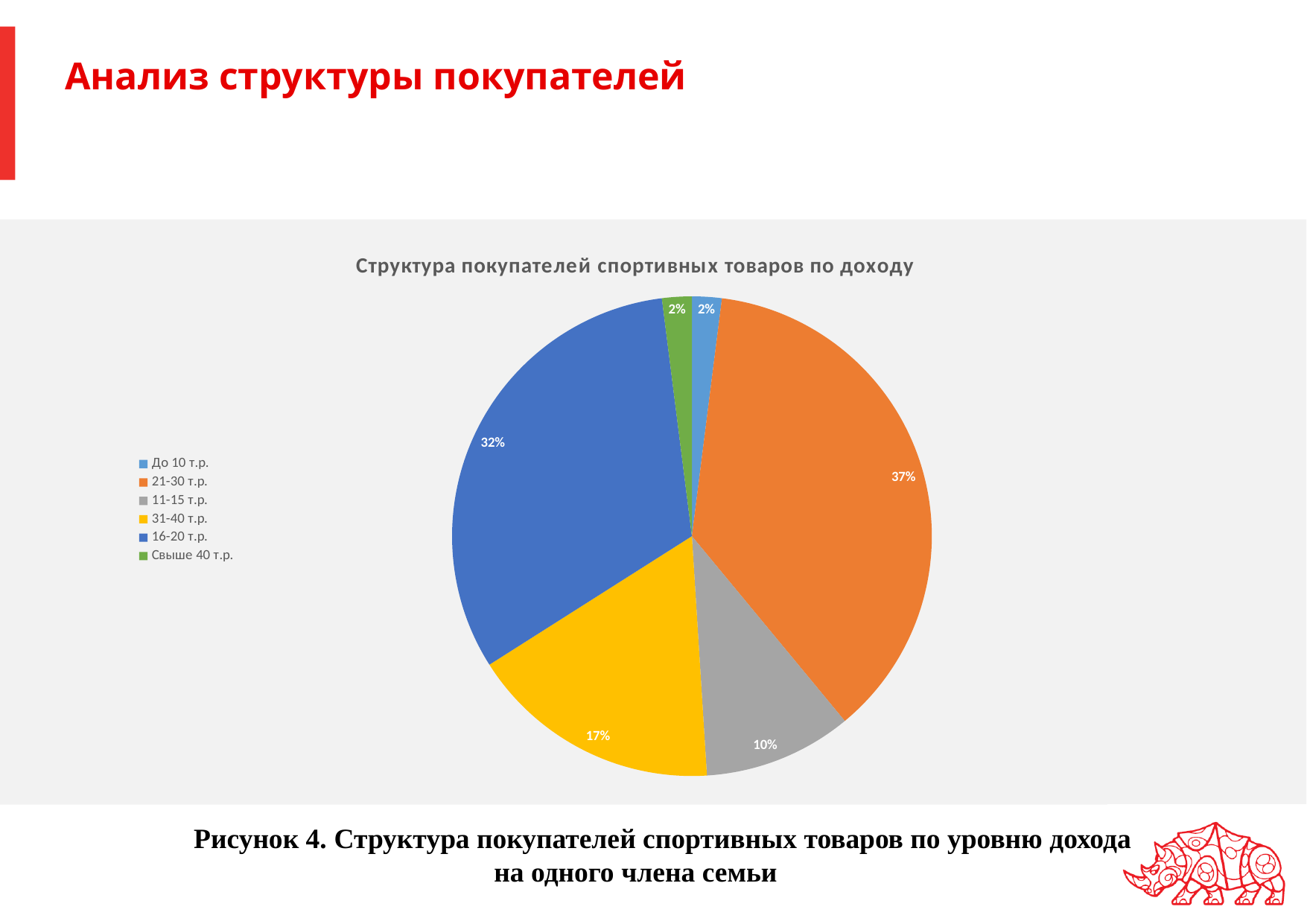
How many income groups does the legend list? 6 What share of buyers falls in the 31-40 т.р. income group? 17% What colour is the slice for the 31-40 т.р. group? yellow What share of buyers falls in the Свыше 40 т.р. income group? 2% Which group has a larger share: 31-40 т.р. or 11-15 т.р.? 31-40 т.р. What is the difference between the shares of the 21-30 т.р. and 16-20 т.р. groups? 5% What is the title of the chart? Структура покупателей спортивных товаров по доходу What share of buyers falls in the 16-20 т.р. income group? 32% What share of buyers falls in the 21-30 т.р. income group? 37% What kind of chart is shown on the slide? pie chart What share of buyers falls in the 11-15 т.р. income group? 10% Which income group has the largest share of buyers? 21-30 т.р.